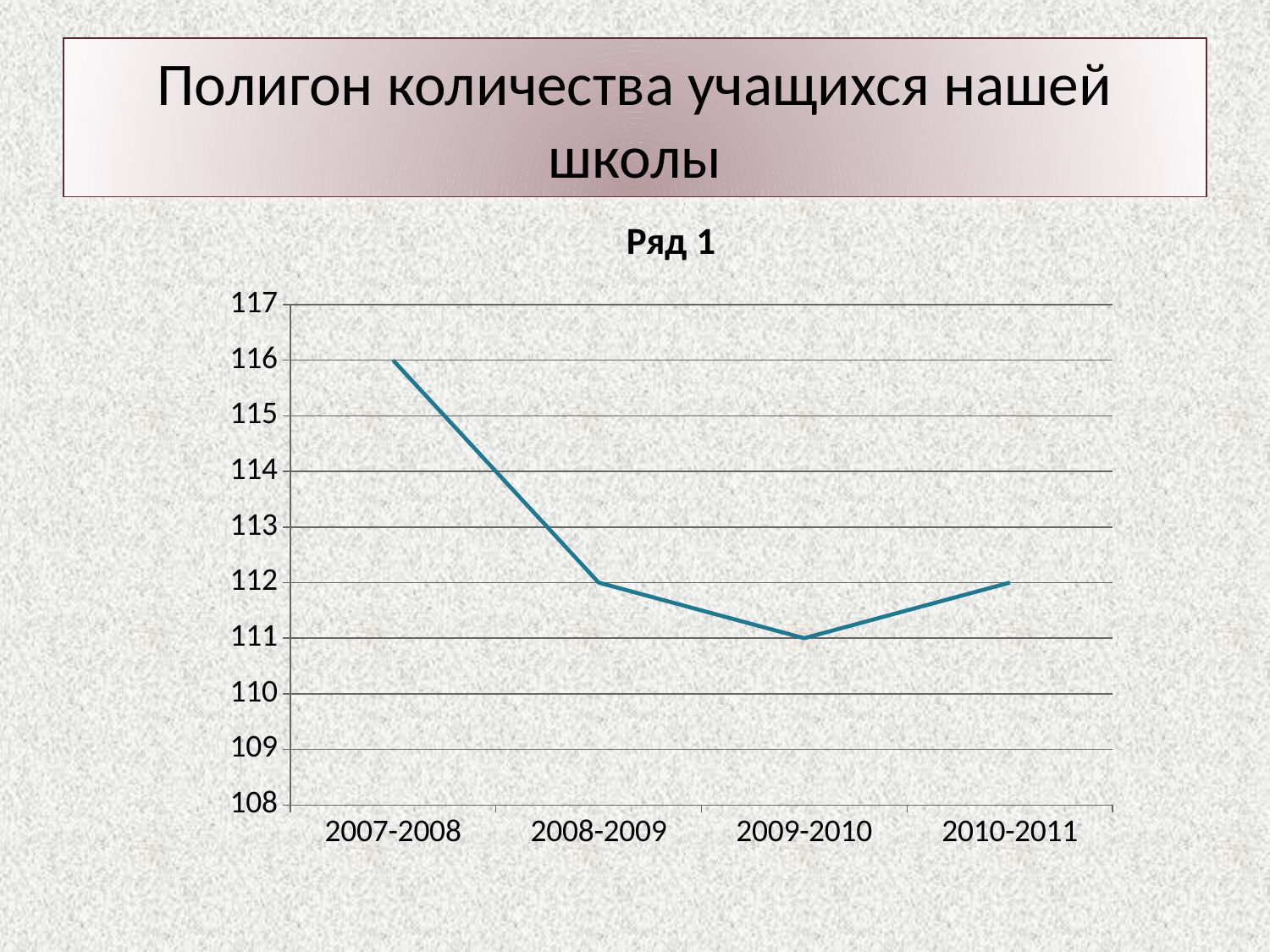
What is the title of the chart? Ряд 1 Which school year has the lowest value? 2009-2010 What is the difference between the values for 2007-2008 and 2008-2009? 4 Do the values rise or fall from 2007-2008 to 2009-2010? fall Which school year has the highest value? 2007-2008 What is the value for 2008-2009? 112 What is the value for 2010-2011? 112 What is the value for 2007-2008? 116 What is the value for 2009-2010? 111 Which is larger, the value for 2007-2008 or the value for 2010-2011? 2007-2008 How many school years are plotted on the x axis? 4 What type of chart is shown on the slide? line chart